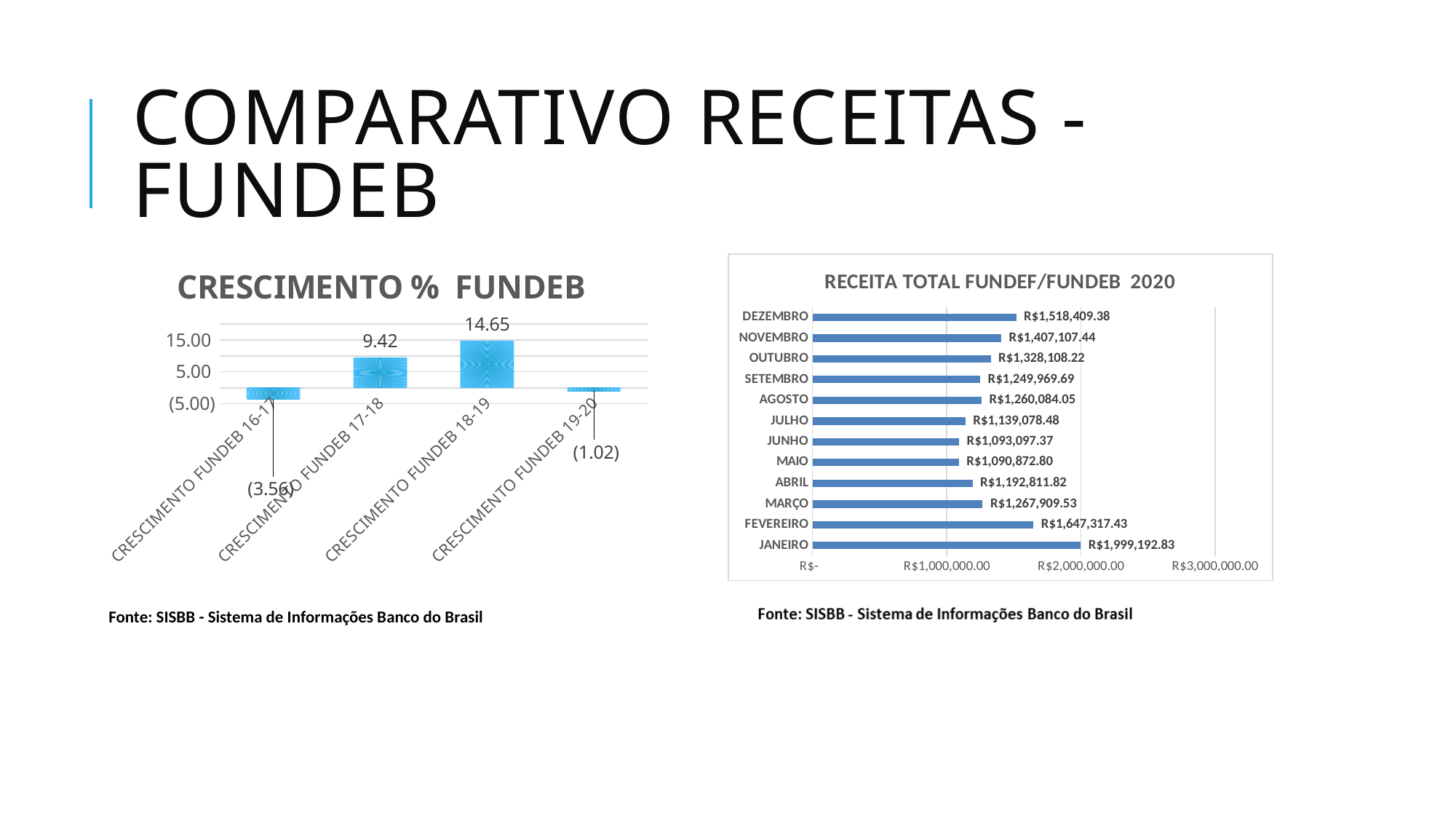
In the 'RECEITA TOTAL FUNDEF/FUNDEB 2020' chart, which month has the highest value? JANEIRO What kind of chart is the 'RECEITA TOTAL FUNDEF/FUNDEB 2020' chart? bar chart In the 'CRESCIMENTO % FUNDEB' chart, which category has the lowest value? CRESCIMENTO FUNDEB 16-17 In the 'RECEITA TOTAL FUNDEF/FUNDEB 2020' chart, is the value for FEVEREIRO larger or smaller than the value for DEZEMBRO? larger In the 'RECEITA TOTAL FUNDEF/FUNDEB 2020' chart, what is the value for JANEIRO? R$1,999,192.83 In the 'RECEITA TOTAL FUNDEF/FUNDEB 2020' chart, which month has the lowest value? MAIO In the 'RECEITA TOTAL FUNDEF/FUNDEB 2020' chart, what is the value for JULHO? R$1,139,078.48 In the 'CRESCIMENTO % FUNDEB' chart, what is the value for CRESCIMENTO FUNDEB 16-17? (3.56) In the 'CRESCIMENTO % FUNDEB' chart, what is the value for CRESCIMENTO FUNDEB 18-19? 14.65 In the 'CRESCIMENTO % FUNDEB' chart, which category has the highest value? CRESCIMENTO FUNDEB 18-19 In the 'CRESCIMENTO % FUNDEB' chart, what is the difference between the values for CRESCIMENTO FUNDEB 18-19 and CRESCIMENTO FUNDEB 17-18? 5.23 In the 'CRESCIMENTO % FUNDEB' chart, how many categories are plotted? 4